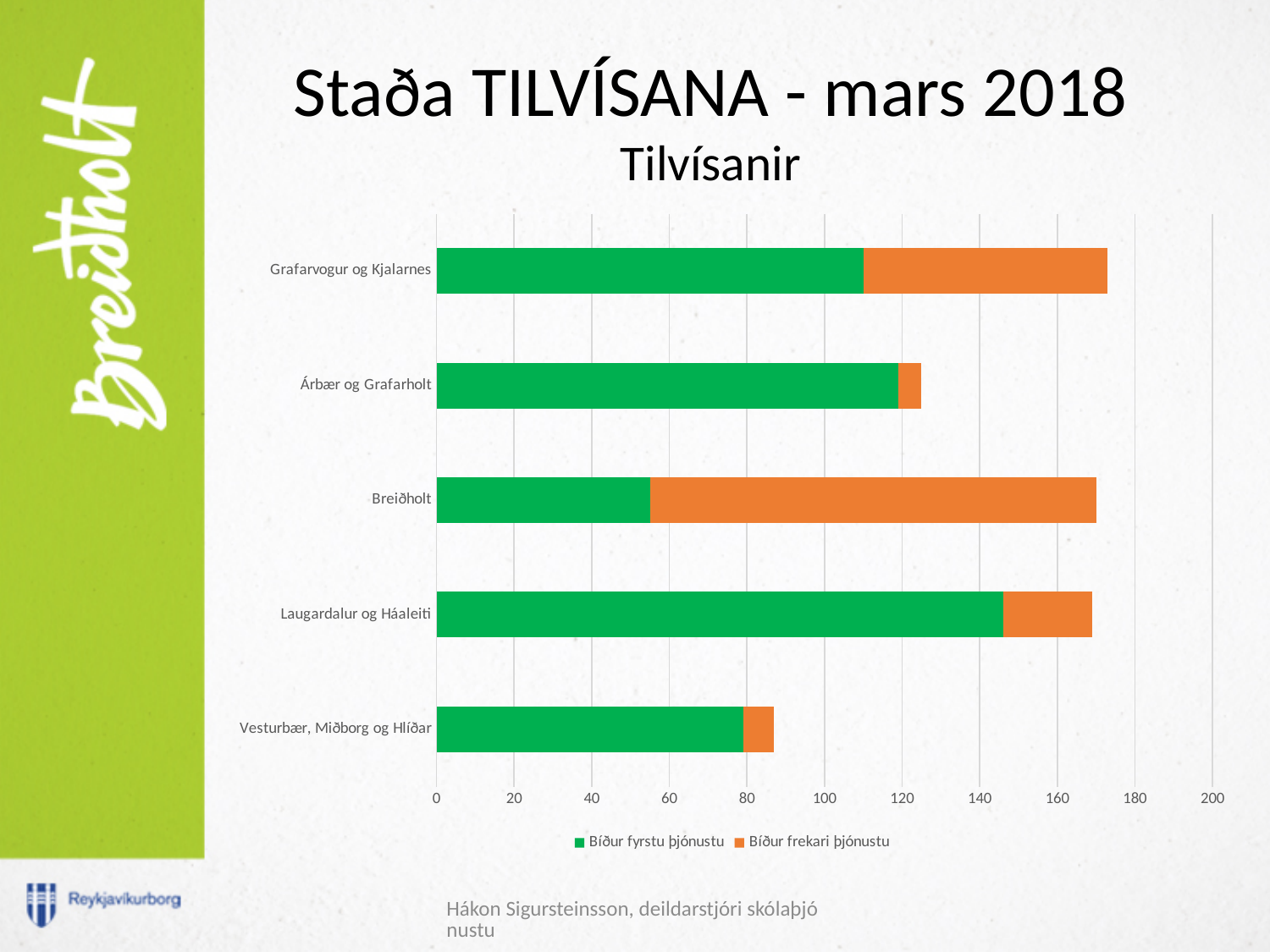
Is the 'Bíður fyrstu þjónustu' value for Laugardalur og Háaleiti greater or less than 140? greater Which series is shown in orange in the legend? Bíður frekari þjónustu Is the total bar for Vesturbær, Miðborg og Hlíðar greater or less than 100? less Is the 'Bíður fyrstu þjónustu' value for Breiðholt greater or less than 60? less What is the title of the chart? Tilvísanir How many series does the legend list? 2 Which category has the smallest total bar? Vesturbær, Miðborg og Hlíðar Which category has the largest 'Bíður frekari þjónustu' segment? Breiðholt How many categories (districts) are shown on the chart? 5 Which category has the lowest value for 'Bíður fyrstu þjónustu'? Breiðholt Which category has the highest value for 'Bíður fyrstu þjónustu'? Laugardalur og Háaleiti What kind of chart is shown on the slide? Stacked bar chart